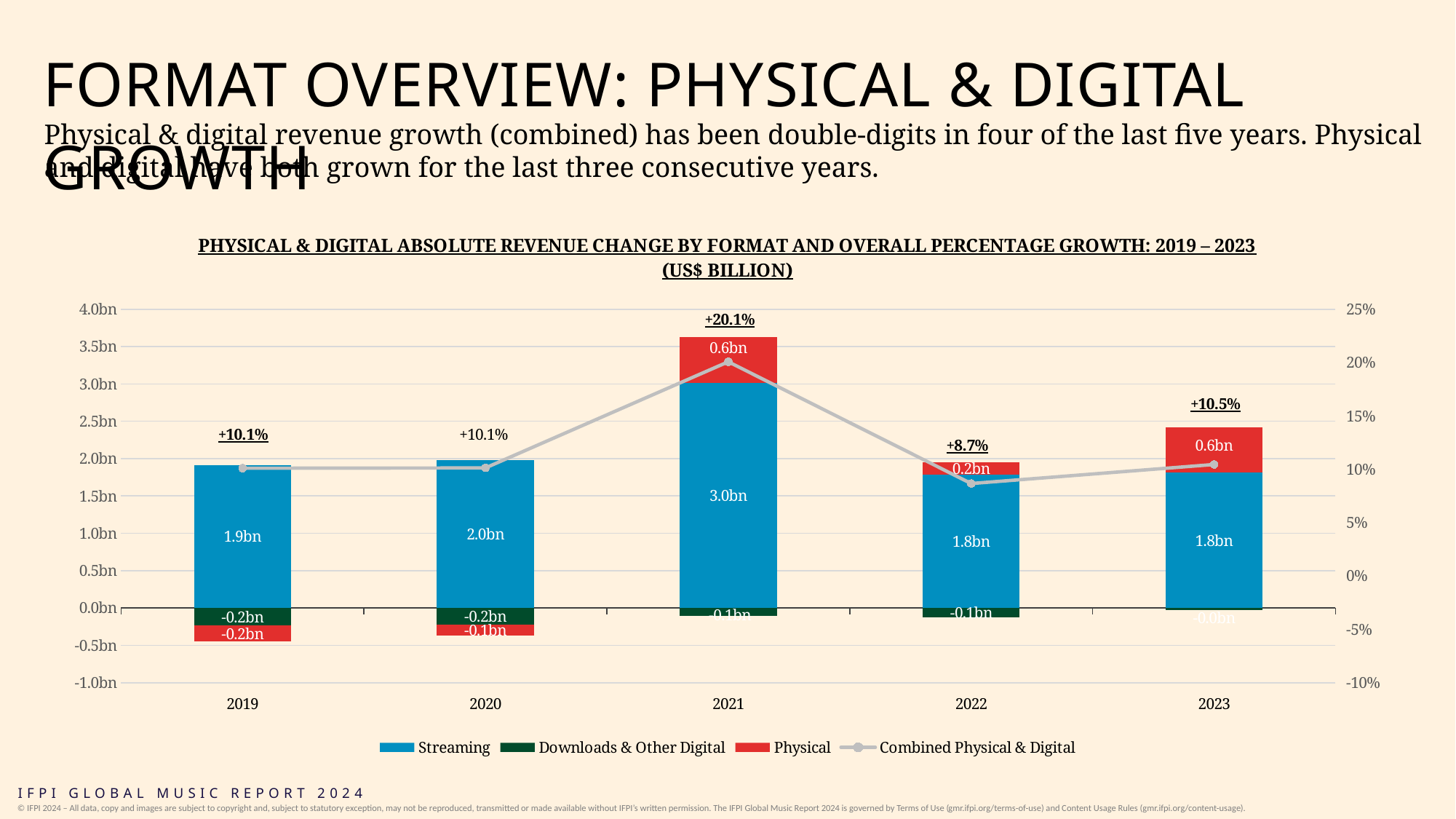
What is the Combined Physical & Digital growth percentage for 2022? +8.7% What is the Streaming value for 2021? 3.0bn What is the Physical value for 2023? 0.6bn Which is larger, the Physical value for 2021 or the Physical value for 2022? 2021 What is the difference between the Streaming values for 2021 and 2022? 1.2bn Which series is shown in red in the legend? Physical What kind of chart is this? Stacked bar chart with a line What is the Downloads & Other Digital value for 2019? -0.2bn How many years are shown on the x axis? 5 In which year is the Streaming value highest? 2021 In which year is the Combined Physical & Digital growth percentage lowest? 2022 How many series does the legend list? 4